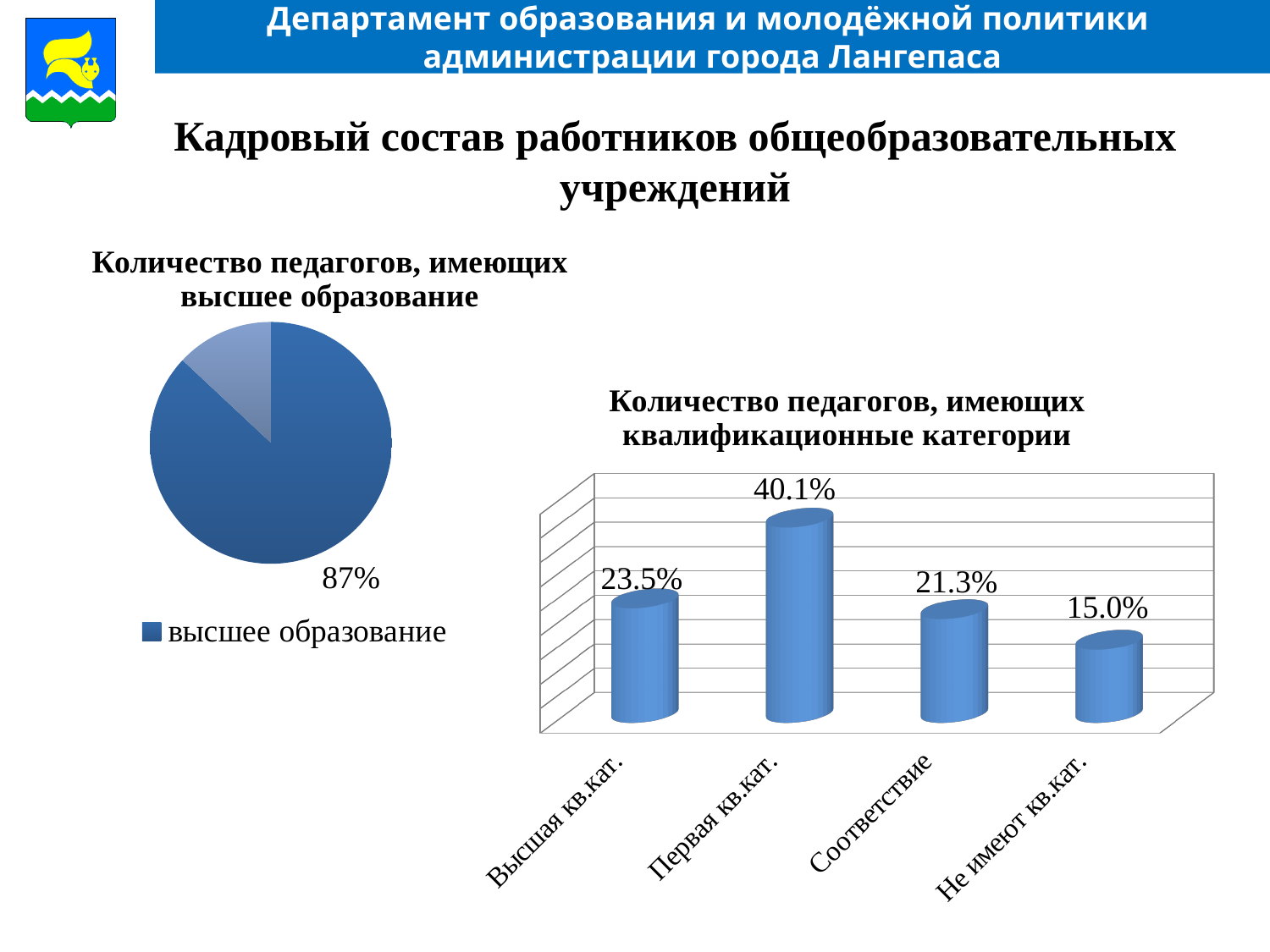
What kind of chart is 'Количество педагогов, имеющих квалификационные категории'? bar chart In the chart 'Количество педагогов, имеющих квалификационные категории', which is larger: the value for 'Высшая кв.кат.' or 'Соответствие'? Высшая кв.кат. In the pie chart 'Количество педагогов, имеющих высшее образование', what share is labelled for the slice 'высшее образование'? 87% In the chart 'Количество педагогов, имеющих квалификационные категории', which category has the highest value? Первая кв.кат. How many categories are shown in the chart 'Количество педагогов, имеющих квалификационные категории'? 4 In the chart 'Количество педагогов, имеющих квалификационные категории', what is the difference between the values for 'Соответствие' and 'Не имеют кв.кат.'? 6.3% In the chart 'Количество педагогов, имеющих квалификационные категории', what is the value for 'Первая кв.кат.'? 40.1% In the chart 'Количество педагогов, имеющих квалификационные категории', what is the difference between the values for 'Первая кв.кат.' and 'Высшая кв.кат.'? 16.6% What kind of chart is 'Количество педагогов, имеющих высшее образование'? pie chart In the chart 'Количество педагогов, имеющих квалификационные категории', what is the value for 'Не имеют кв.кат.'? 15.0% In the chart 'Количество педагогов, имеющих квалификационные категории', which category has the lowest value? Не имеют кв.кат. In the chart 'Количество педагогов, имеющих квалификационные категории', what is the value for 'Соответствие'? 21.3%